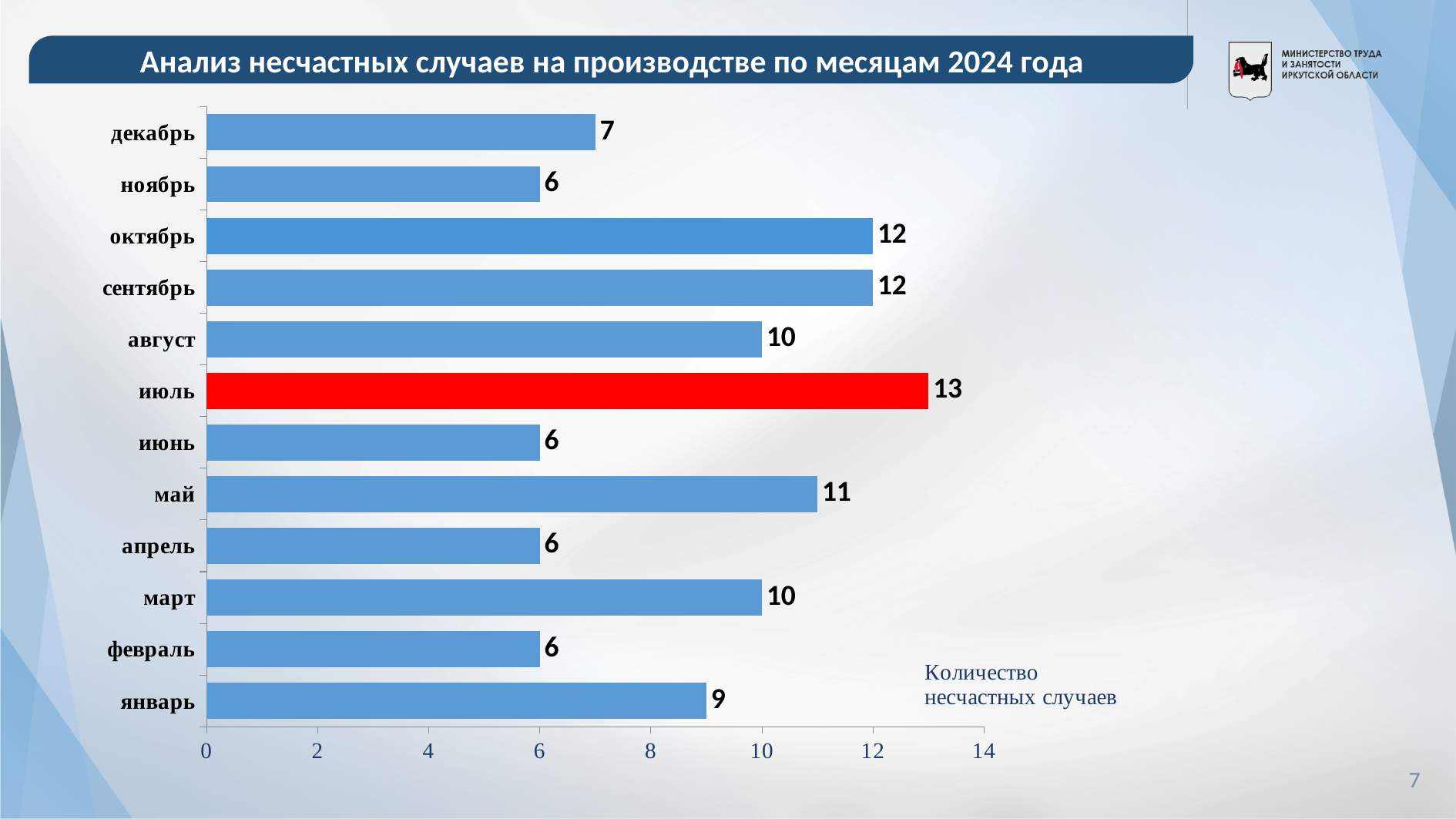
What is the value for июль? 13 What kind of chart is shown on the slide? bar chart Which month has the highest value? июль What is the title of the chart? Анализ несчастных случаев на производстве по месяцам 2024 года What is the difference between the values for июль and июнь? 7 What is the value for май? 11 Which is larger, the value for август or the value for декабрь? август How many months are shown on the chart? 12 What is the value for январь? 9 What is the difference between the values for сентябрь and ноябрь? 6 Which bar is coloured red? июль Is the value for октябрь greater or less than 10? greater